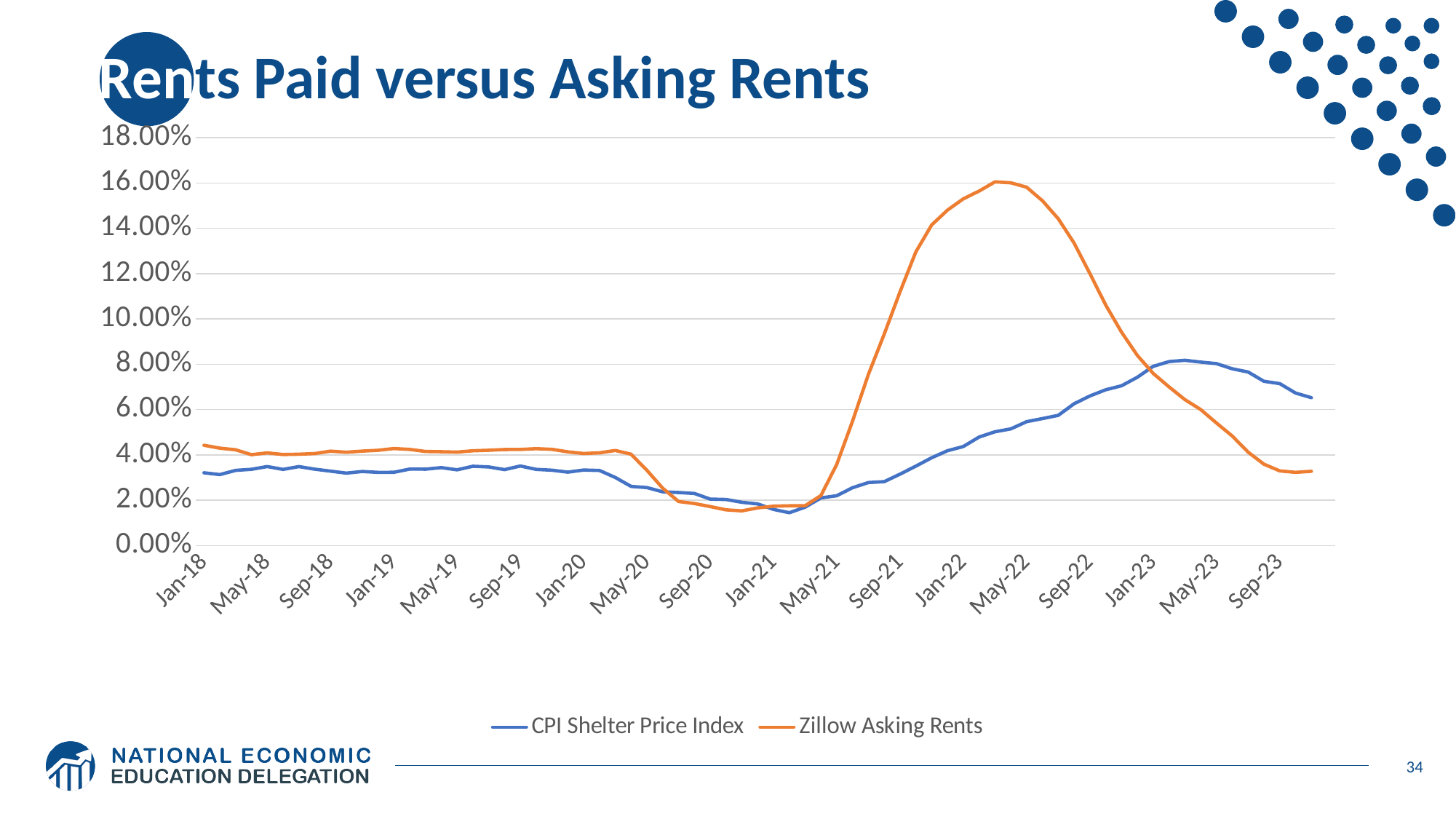
How many date labels are shown on the x axis? 18 At Jan-22, which series has the higher value, CPI Shelter Price Index or Zillow Asking Rents? Zillow Asking Rents Is the peak value of Zillow Asking Rents greater or less than 14.00%? greater How many series does the legend list? 2 Which two series are listed in the legend? CPI Shelter Price Index and Zillow Asking Rents What kind of chart is shown on the slide? Line chart Is the peak value of the CPI Shelter Price Index greater or less than 10.00%? less At May-23, which series has the higher value, CPI Shelter Price Index or Zillow Asking Rents? CPI Shelter Price Index What is the title of the chart? Rents Paid versus Asking Rents Which series reaches the higher peak value over the period shown? Zillow Asking Rents Does Zillow Asking Rents rise or fall between May-22 and Sep-23? fall Is the value of Zillow Asking Rents at Jan-21 greater or less than 2.00%? less